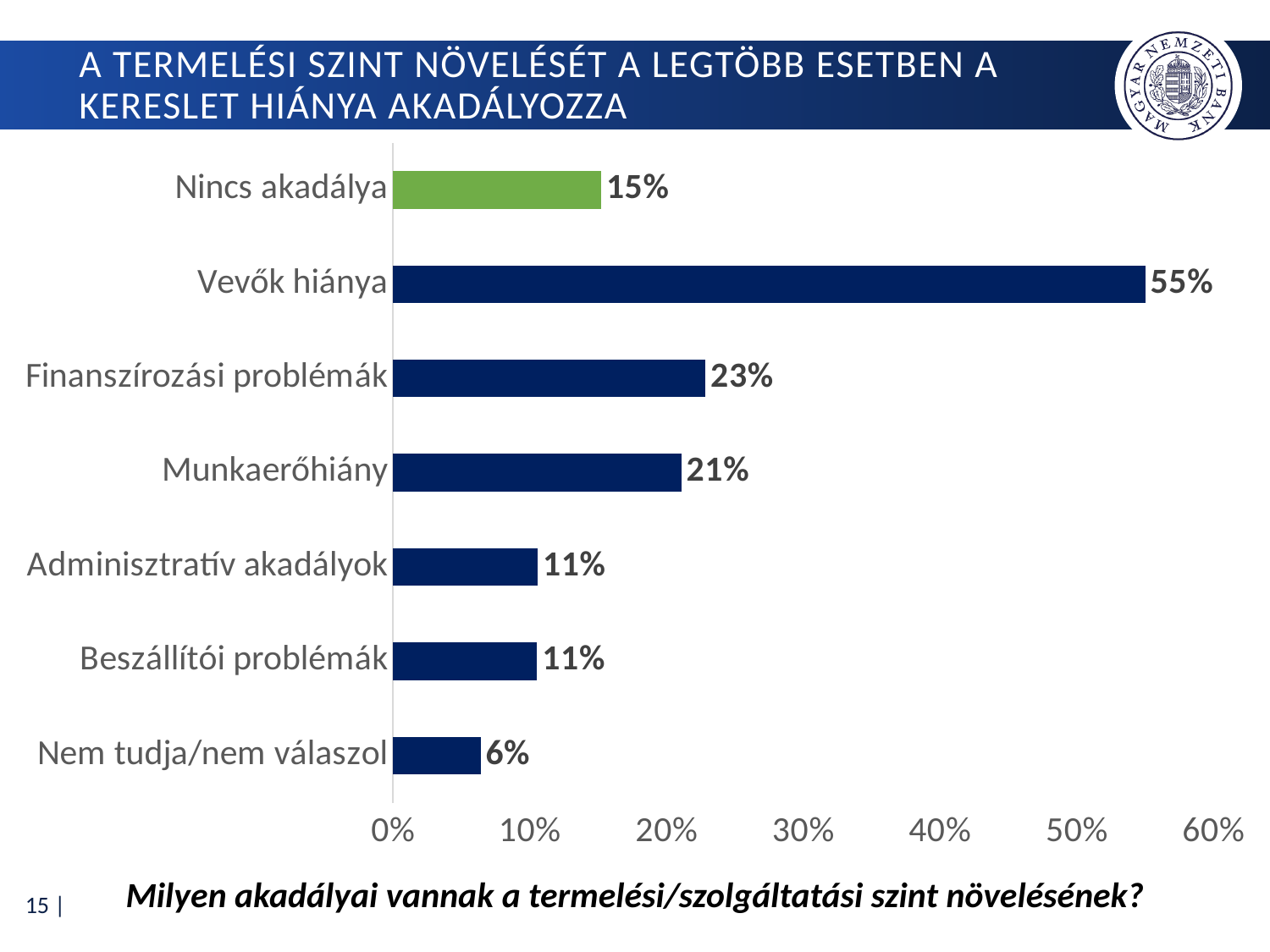
What is the difference between the values for Finanszírozási problémák and Munkaerőhiány? 2% Is the value for Vevők hiánya greater or less than 50%? greater Which category has the lowest value? Nem tudja/nem válaszol What is the value for Vevők hiánya? 55% What is the value for Munkaerőhiány? 21% What is the difference between the values for Vevők hiánya and Finanszírozási problémák? 32% Which is larger, the value for Nincs akadálya or the value for Adminisztratív akadályok? Nincs akadálya What is the value for Nem tudja/nem válaszol? 6% What kind of chart is shown on the slide? Bar chart Which category has the highest value? Vevők hiánya What is the value for Nincs akadálya? 15% How many categories are shown in the chart? 7